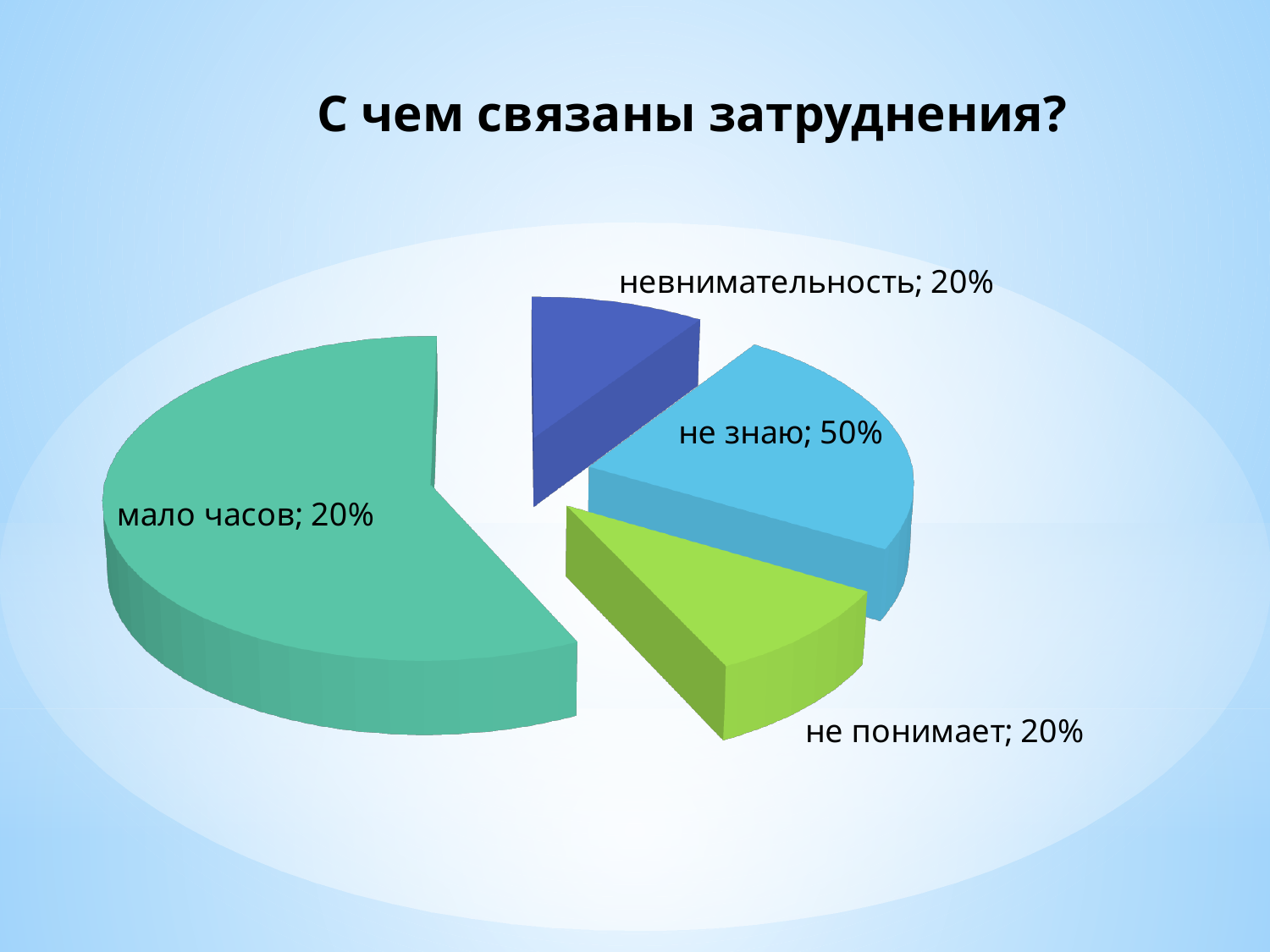
What is the title of the chart? С чем связаны затруднения? Which category is labelled on the dark blue slice? невнимательность What kind of chart is shown on the slide? pie chart What is the value shown for "не знаю"? 50% What is the value shown for "невнимательность"? 20% How many slices does the pie chart have? 4 What is the value shown for "не понимает"? 20% What is the value shown for "мало часов"? 20%